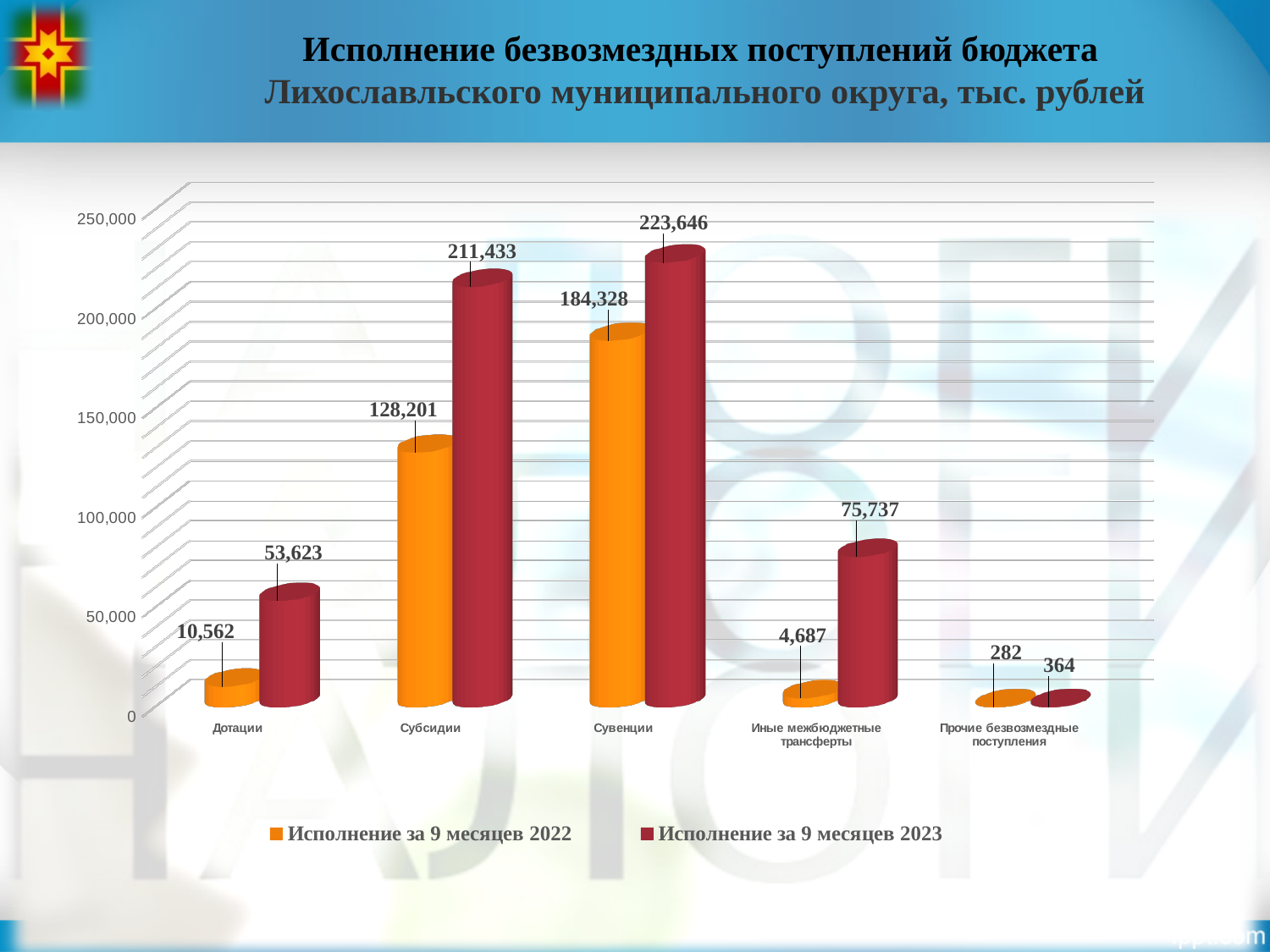
Which is larger for Субсидии: the value for Исполнение за 9 месяцев 2022 or Исполнение за 9 месяцев 2023? Исполнение за 9 месяцев 2023 What is the difference between the 2023 and 2022 values for Субвенции? 39,318 Which category has the lowest value in the series Исполнение за 9 месяцев 2023? Прочие безвозмездные поступления Which category has the highest value in the series Исполнение за 9 месяцев 2022? Сувенции What is the difference between the 2023 and 2022 values for Дотации? 43,061 How many categories are shown on the x axis? 5 What is the value for Субвенции in the series Исполнение за 9 месяцев 2023? 223,646 How many series does the legend list? 2 Is the value for Субсидии in the series Исполнение за 9 месяцев 2023 greater or less than 200,000? greater What kind of chart is shown on the slide? Bar chart What is the value for Субсидии in the series Исполнение за 9 месяцев 2022? 128,201 What is the value for Иные межбюджетные трансферты in the series Исполнение за 9 месяцев 2023? 75,737